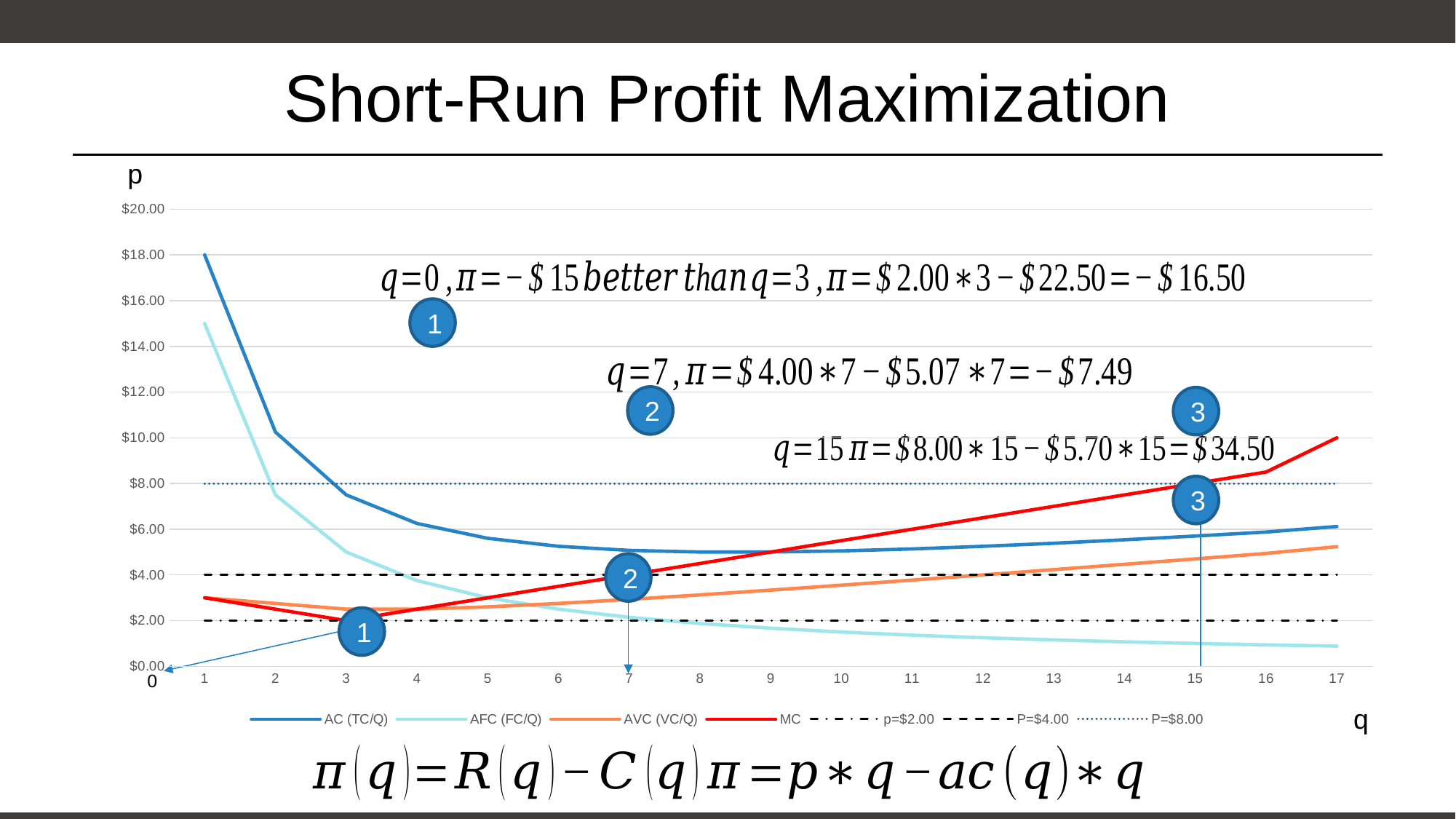
Which series has the highest value at q=1? AC (TC/Q) What is the legend label of the dotted horizontal line drawn at $8.00? P=$8.00 Which series has the lowest value at q=17? AFC (FC/Q) Is the value of AC (TC/Q) at q=1 greater or less than $16.00? greater Is the value of MC at q=17 greater or less than $8.00? greater How many series does the chart legend list? 7 At q=17, which is higher: AC (TC/Q) or AVC (VC/Q)? AC (TC/Q) Is the value of AFC (FC/Q) at q=1 greater or less than $14.00? greater How many labelled points are there on the q (x) axis of the chart? 17 Does the AFC (FC/Q) line rise or fall as q increases from 1 to 17? falls What kind of chart is shown on the slide? line chart